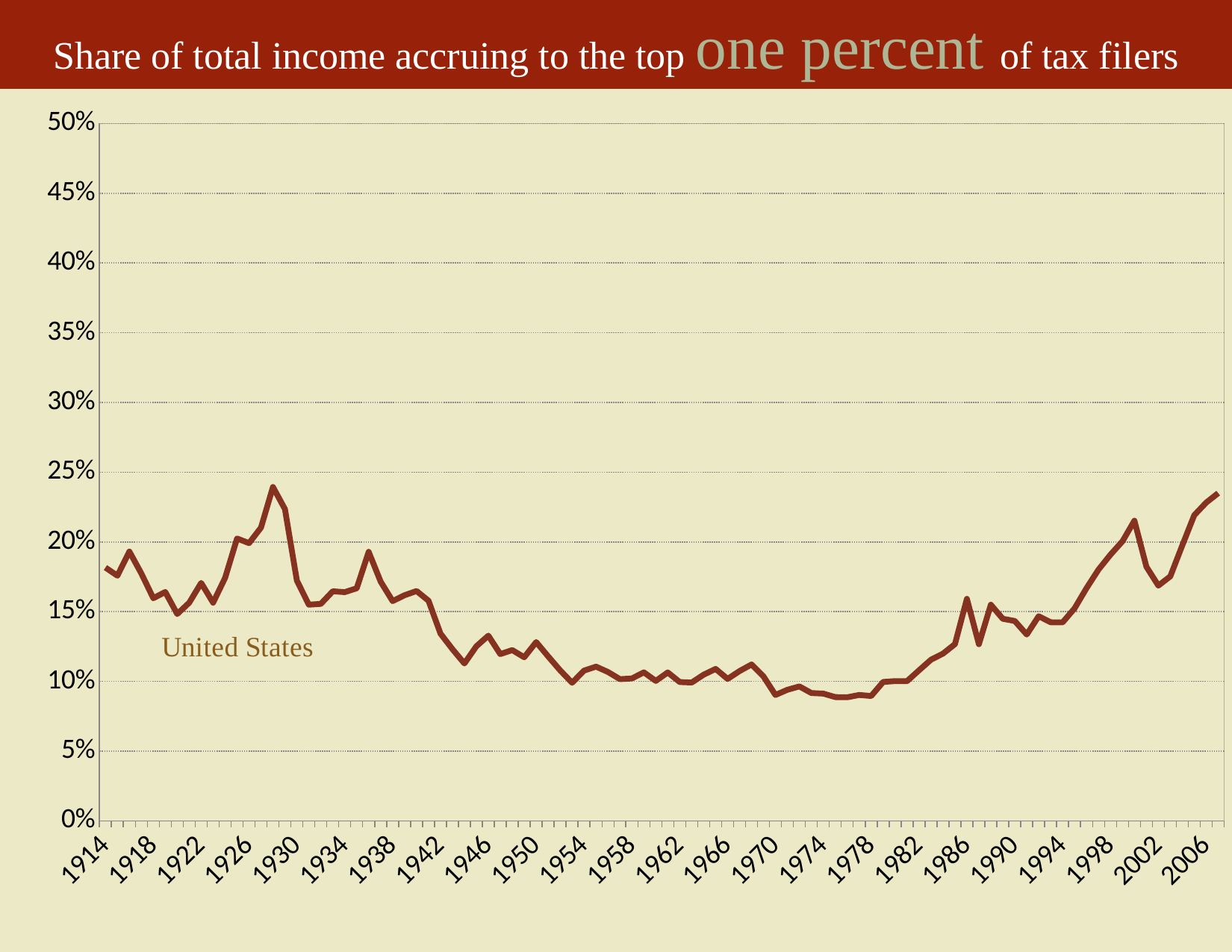
Is the value for 1928 larger or smaller than the value for 1976? larger Is the value for 1950 greater or less than 15%? less Is the value for 1928 greater or less than 20%? greater Is the value for 1976 greater or less than 10%? less How many series are plotted on the chart? 1 Does the line rise or fall between 1928 and 1932? fall Does the line generally rise or fall between 1978 and 2006? rise Which country does the plotted line represent? United States What is the title of the chart? Share of total income accruing to the top one percent of tax filers What kind of chart is shown on the slide? line chart